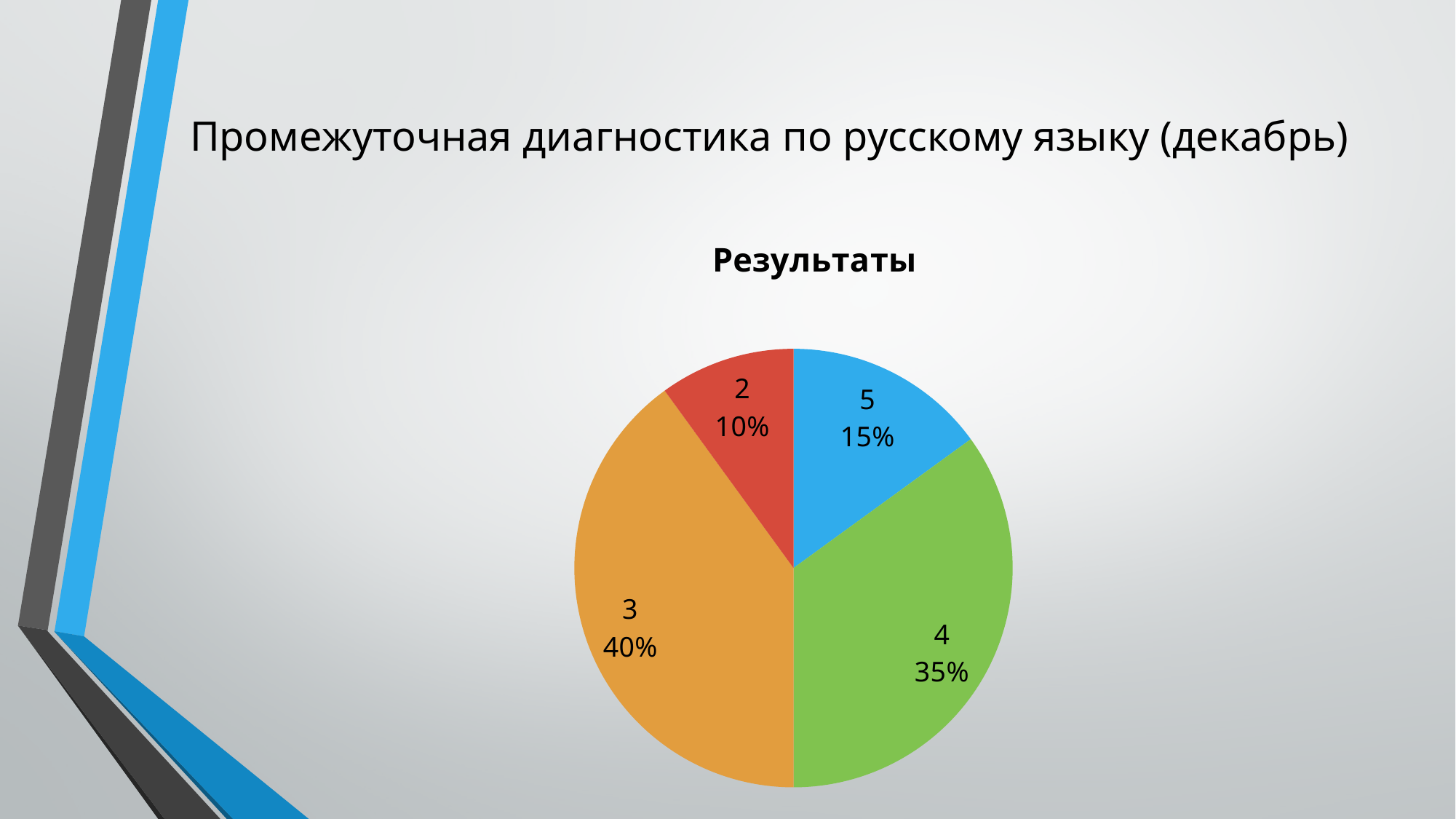
Which grade has the largest slice of the pie? 3 What share of the pie does the slice for grade 4 represent? 35% How many slices does the pie chart have? 4 What share of the pie does the slice for grade 5 represent? 15% What kind of chart is shown on the slide? pie chart What colour is the slice for grade 4? green Which slice is larger, grade 5 or grade 2? 5 Which grade has the smallest slice of the pie? 2 What is the title of the chart? Результаты What share of the pie does the slice for grade 3 represent? 40% What is the difference in percentage points between the slices for grade 3 and grade 4? 5%